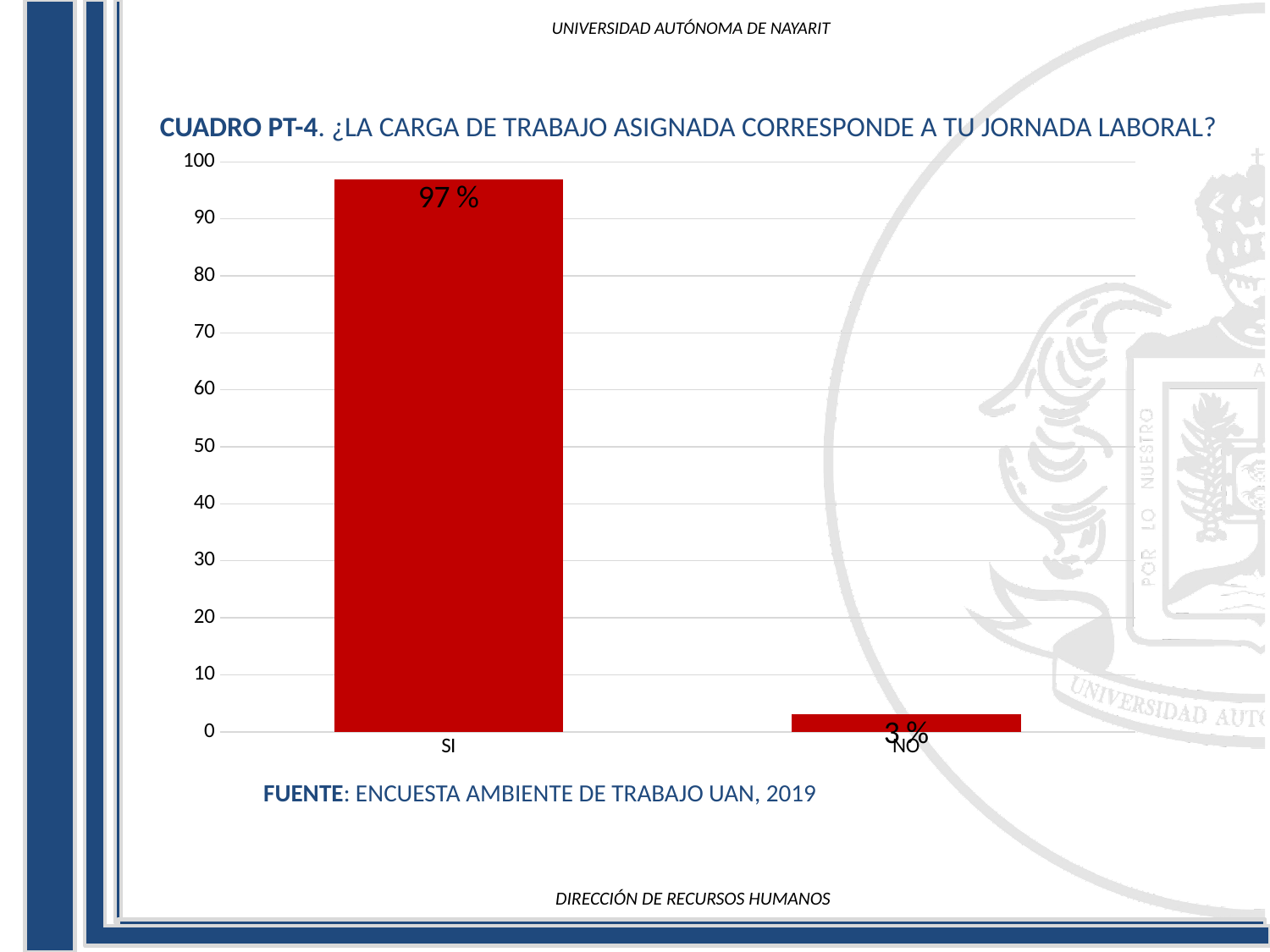
How many categories are shown on the x axis? 2 Which category has the highest value? SI What is the difference between the values for SI and NO? 94 % Which category has the lowest value? NO Is the value for NO greater or less than 10? less Is the value for SI greater or less than 90? greater What kind of chart is shown on the slide? bar chart What is the value for NO? 3 % What is the source cited below the chart? ENCUESTA AMBIENTE DE TRABAJO UAN, 2019 Which is larger, the value for SI or the value for NO? SI What is the value for SI? 97 % What is the maximum value shown on the y axis? 100